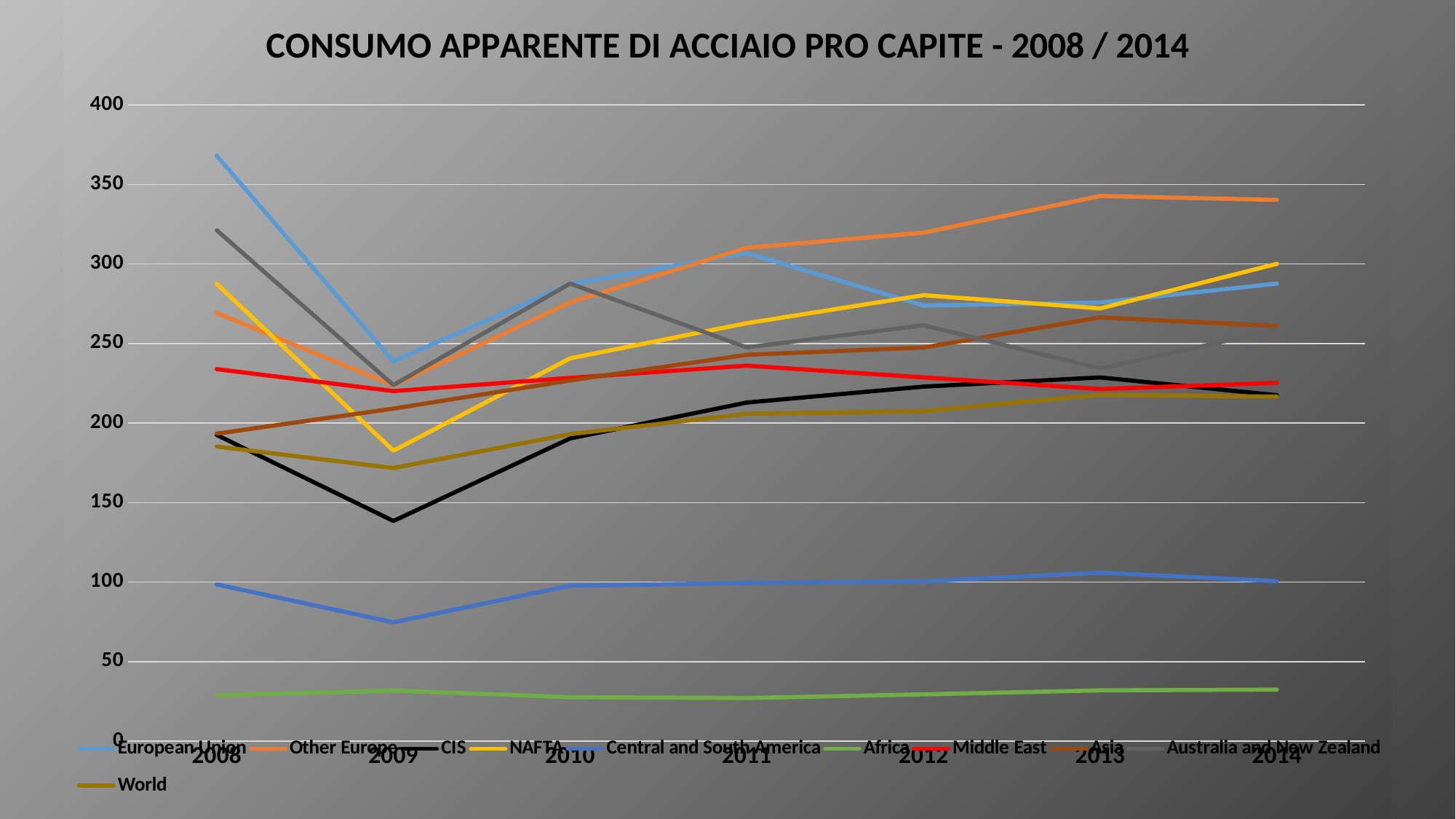
Which series has the highest value in 2014? Other Europe How many years are plotted along the x axis? 7 What kind of chart is shown on the slide? line chart What is the title of the chart? CONSUMO APPARENTE DI ACCIAIO PRO CAPITE - 2008 / 2014 Does the Other Europe line rise or fall from 2009 to 2013? rise Which series has the lowest value in 2008? Africa Is the value for CIS in 2009 greater or less than 150? less Is the value for NAFTA in 2009 greater or less than 200? less Is the value for European Union in 2008 greater or less than 350? greater In 2008, which is larger: European Union or Australia and New Zealand? European Union How many series does the legend list? 10